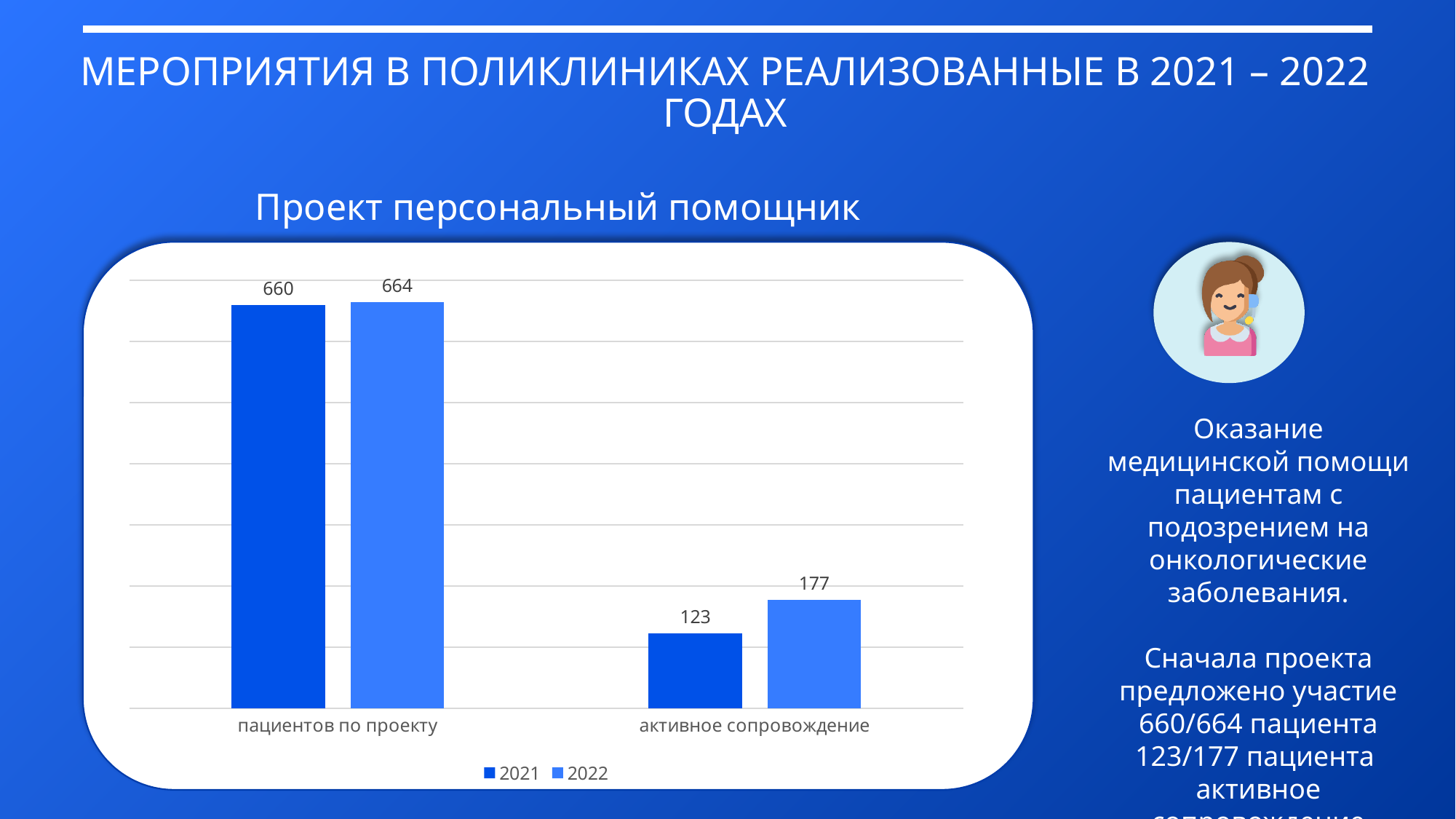
What is the difference between the 2022 and 2021 values for 'пациентов по проекту'? 4 What is the value for 2022 in the 'пациентов по проекту' category? 664 Which category has the highest value for the 2022 series? пациентов по проекту What type of chart is shown on the slide? Bar chart For 'активное сопровождение', which series has the larger value, 2021 or 2022? 2022 Which category has the lowest value for the 2021 series? активное сопровождение What is the difference between the 2022 and 2021 values for 'активное сопровождение'? 54 What is the value for 2022 in the 'активное сопровождение' category? 177 How many categories are shown on the x axis? 2 What is the value for 2021 in the 'активное сопровождение' category? 123 What is the value for 2021 in the 'пациентов по проекту' category? 660 How many series does the legend list? 2